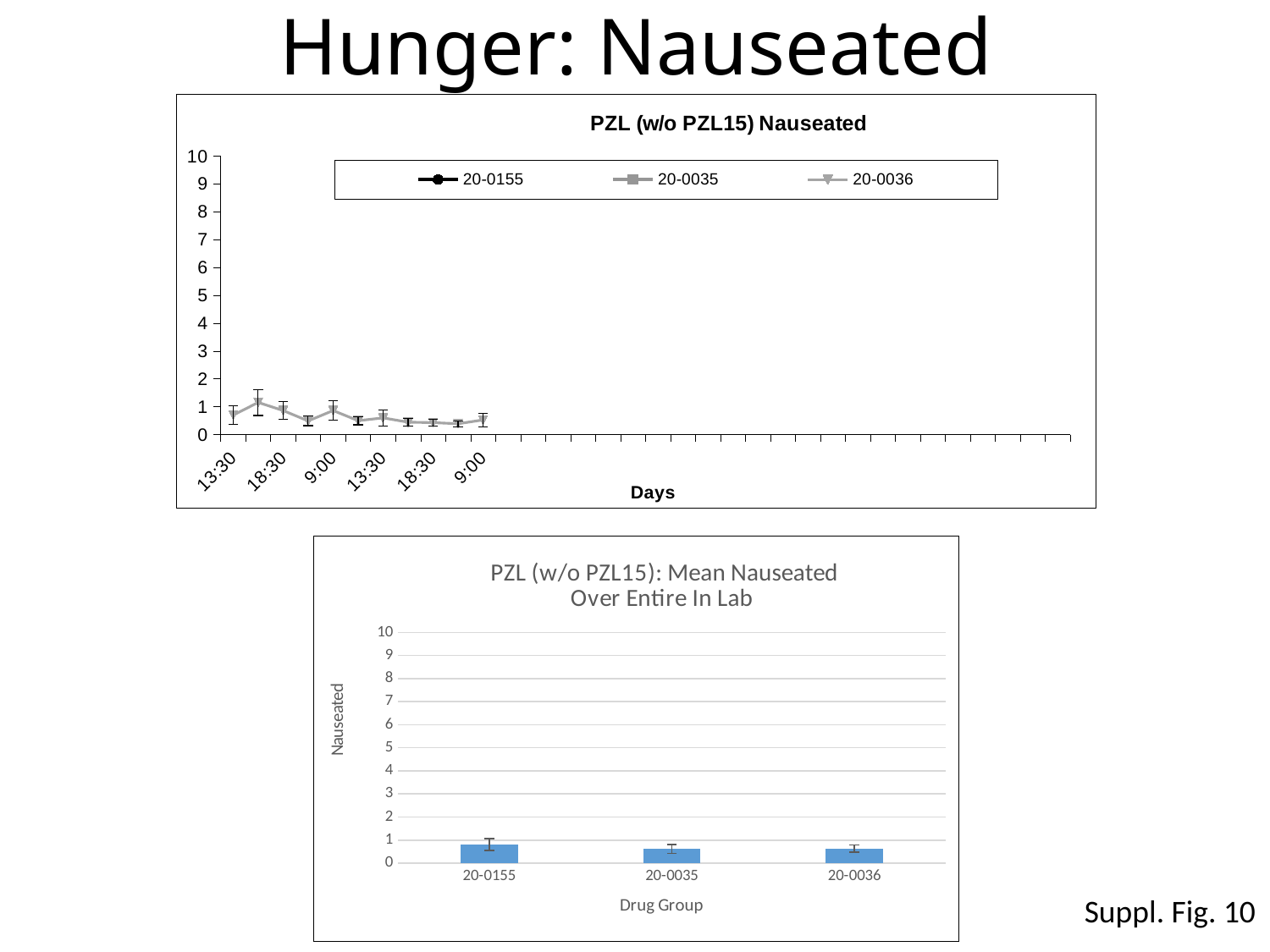
In the bottom chart "PZL (w/o PZL15): Mean Nauseated Over Entire In Lab", is the value for 20-0036 greater or less than 2? less What type of chart is the top chart titled "PZL (w/o PZL15) Nauseated"? line chart In the top chart "PZL (w/o PZL15) Nauseated", what is the maximum value shown on the y axis? 10 What is the x-axis title of the bottom chart "PZL (w/o PZL15): Mean Nauseated Over Entire In Lab"? Drug Group How many series does the legend of the top chart "PZL (w/o PZL15) Nauseated" list? 3 What type of chart is the bottom chart titled "PZL (w/o PZL15): Mean Nauseated Over Entire In Lab"? bar chart How many categories are shown on the x axis of the bottom chart "PZL (w/o PZL15): Mean Nauseated Over Entire In Lab"? 3 In the bottom chart "PZL (w/o PZL15): Mean Nauseated Over Entire In Lab", which drug group has the highest bar? 20-0155 In the bottom chart "PZL (w/o PZL15): Mean Nauseated Over Entire In Lab", which is larger, the value for 20-0155 or the value for 20-0035? 20-0155 What is the x-axis title of the top chart "PZL (w/o PZL15) Nauseated"? Days In the bottom chart "PZL (w/o PZL15): Mean Nauseated Over Entire In Lab", is the value for 20-0155 greater or less than 1? less In the top chart "PZL (w/o PZL15) Nauseated", are all plotted values greater or less than 2? less